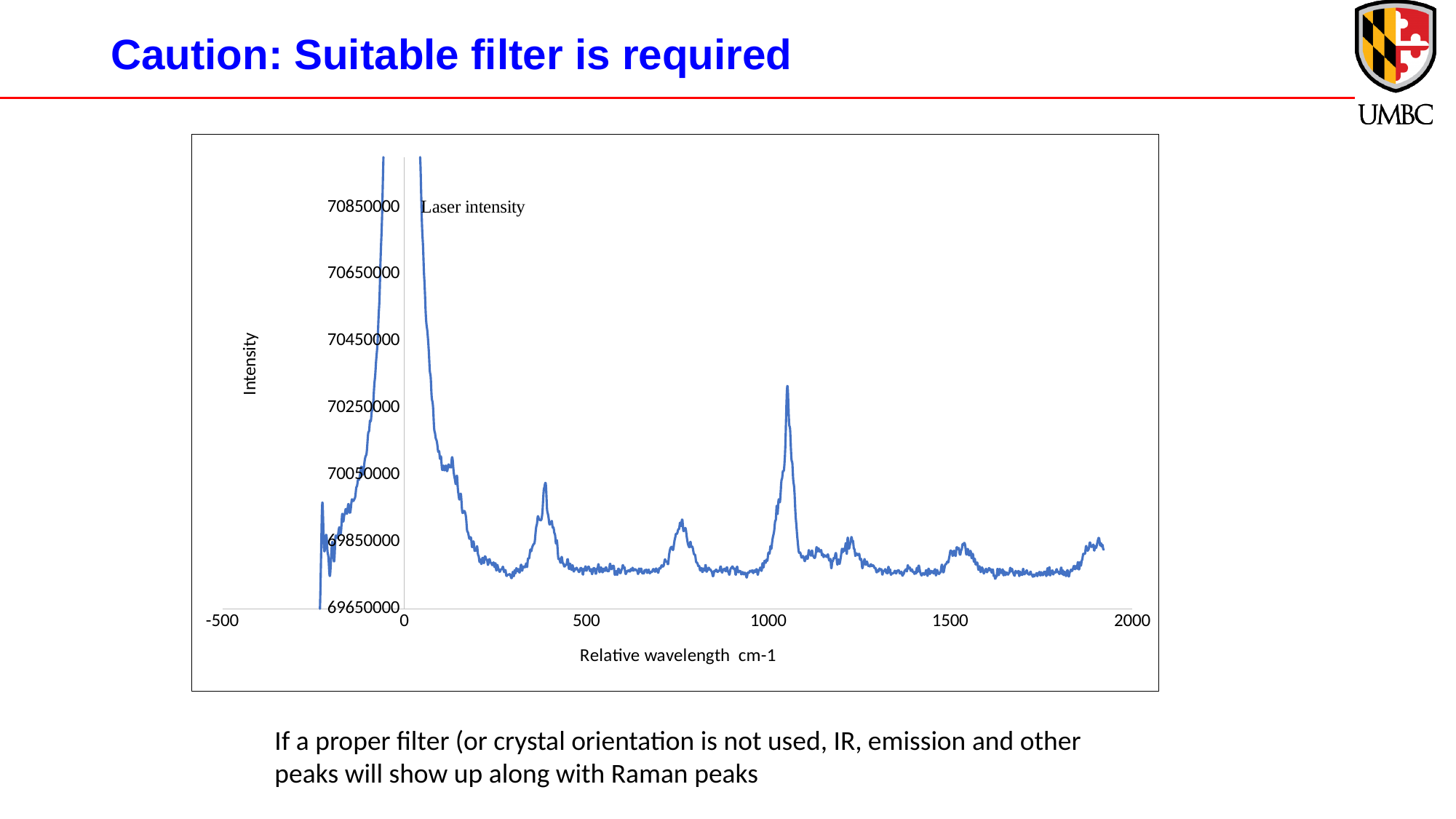
What is the title of the x axis of the chart? Relative wavelength cm-1 Which peak is higher: the one near 400 cm-1 or the one near 1050 cm-1? the one near 1050 cm-1 Is the intensity at the peak near 1050 cm-1 greater or less than 70050000? greater Is the baseline intensity around 1400 cm-1 greater or less than 69850000? less Which peak is higher: the one near 750 cm-1 or the one near 400 cm-1? the one near 400 cm-1 What text label is placed next to the tall peak near 0 cm-1 on the chart? Laser intensity Is the intensity at the peak near 1050 cm-1 greater or less than 70650000? less What kind of chart is shown on the slide? line chart Do the intensity values rise or fall as the relative wavelength increases from about 50 cm-1 to about 300 cm-1? fall